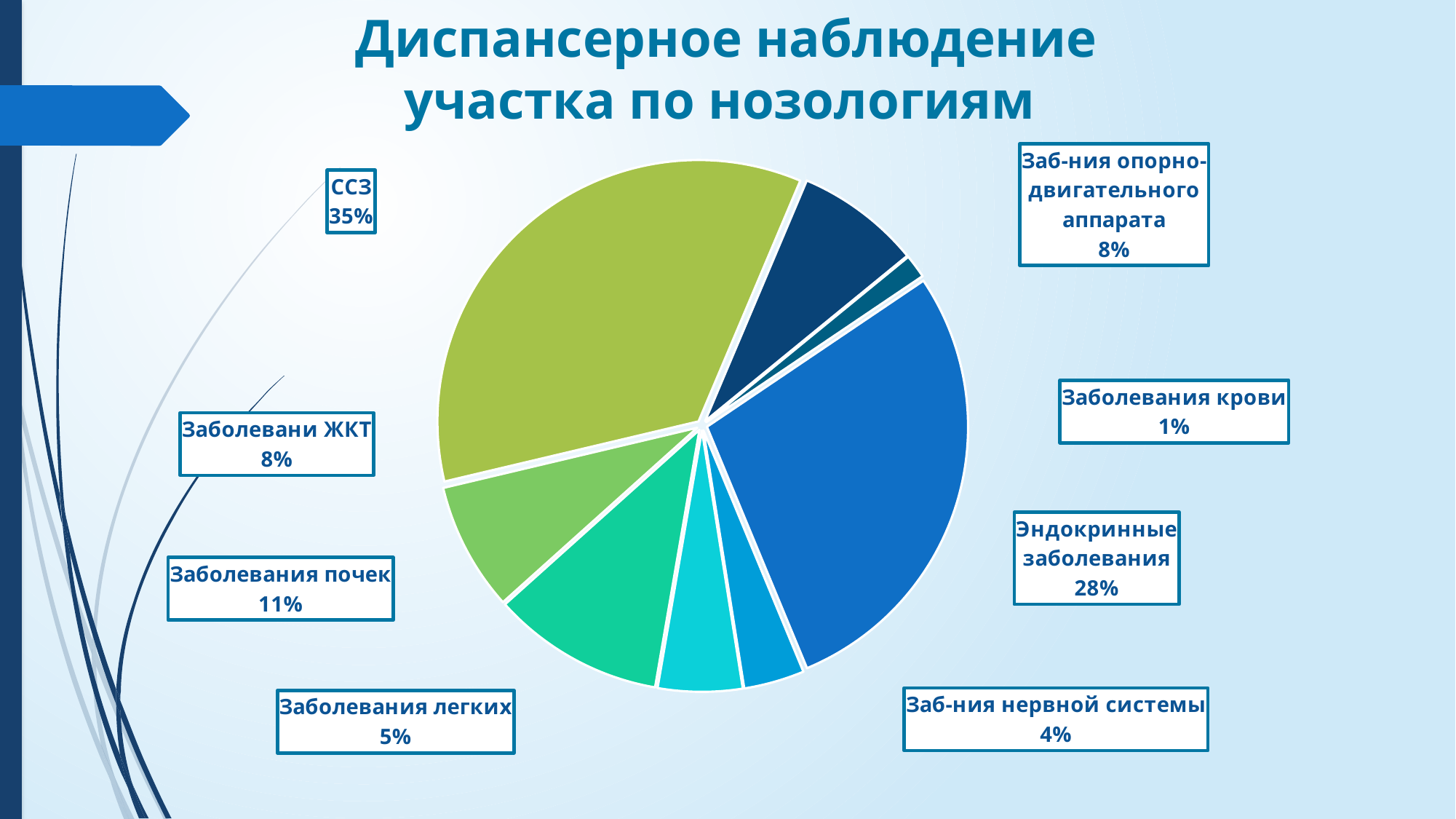
Which category has the largest share of the pie? ССЗ What is the difference between the shares of ССЗ and Эндокринные заболевания? 7% What is the combined share of Заб-ния нервной системы and Заболевания легких? 9% What is the value for Заболевания почек? 11% What is the value for Заболевания крови? 1% What is the value for Эндокринные заболевания? 28% What is the title of the chart on the slide? Диспансерное наблюдение участка по нозологиям How many categories are shown in the pie chart? 8 Which is larger: the share for Заболевания почек or the share for Заболевания легких? Заболевания почек What kind of chart is shown on the slide? pie chart Which category has the smallest share of the pie? Заболевания крови What share of the pie does ССЗ account for? 35%